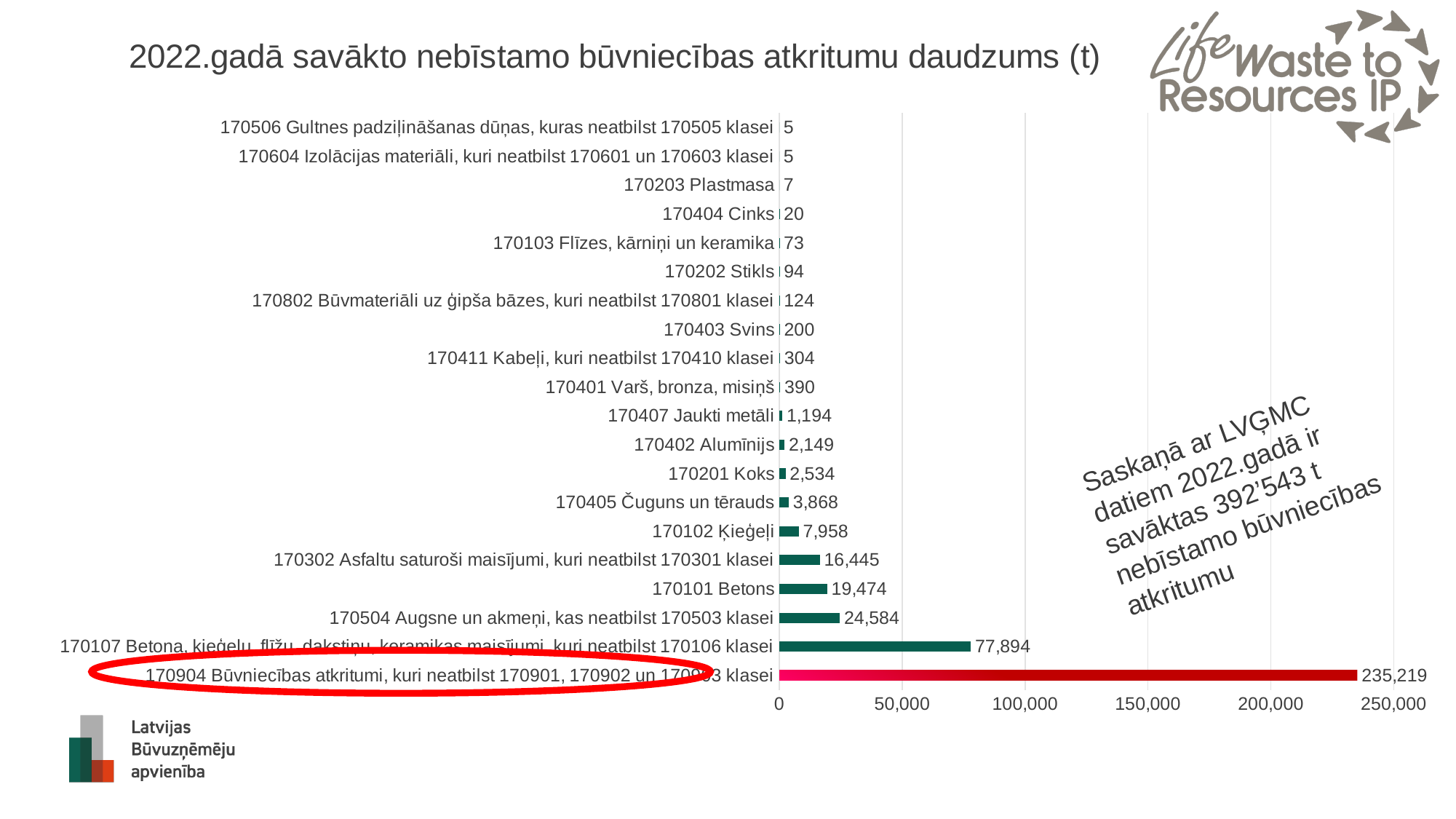
Which is larger, the value for 170302 Asfaltu saturoši maisījumi or the value for 170101 Betons? 170101 Betons What is the difference between the values for 170107 Betona, ķieģeļu, flīžu, dakstiņu, keramikas maisījumi and 170504 Augsne un akmeņi? 53,310 What is the value of the largest bar? 235,219 What is the value for 170101 Betons? 19,474 What is the value for 170102 Ķieģeļi? 7,958 What is the title of the chart? 2022.gadā savākto nebīstamo būvniecības atkritumu daudzums (t) Which category has the highest value? 170904 Būvniecības atkritumi, kuri neatbilst 170901, 170902 un 170903 klasei Is the value for 170107 Betona, ķieģeļu, flīžu, dakstiņu, keramikas maisījumi greater or less than 100,000? less How many categories are plotted in the chart? 20 What is the value for 170403 Svins? 200 What is the value for 170201 Koks? 2,534 What kind of chart is shown on the slide? bar chart